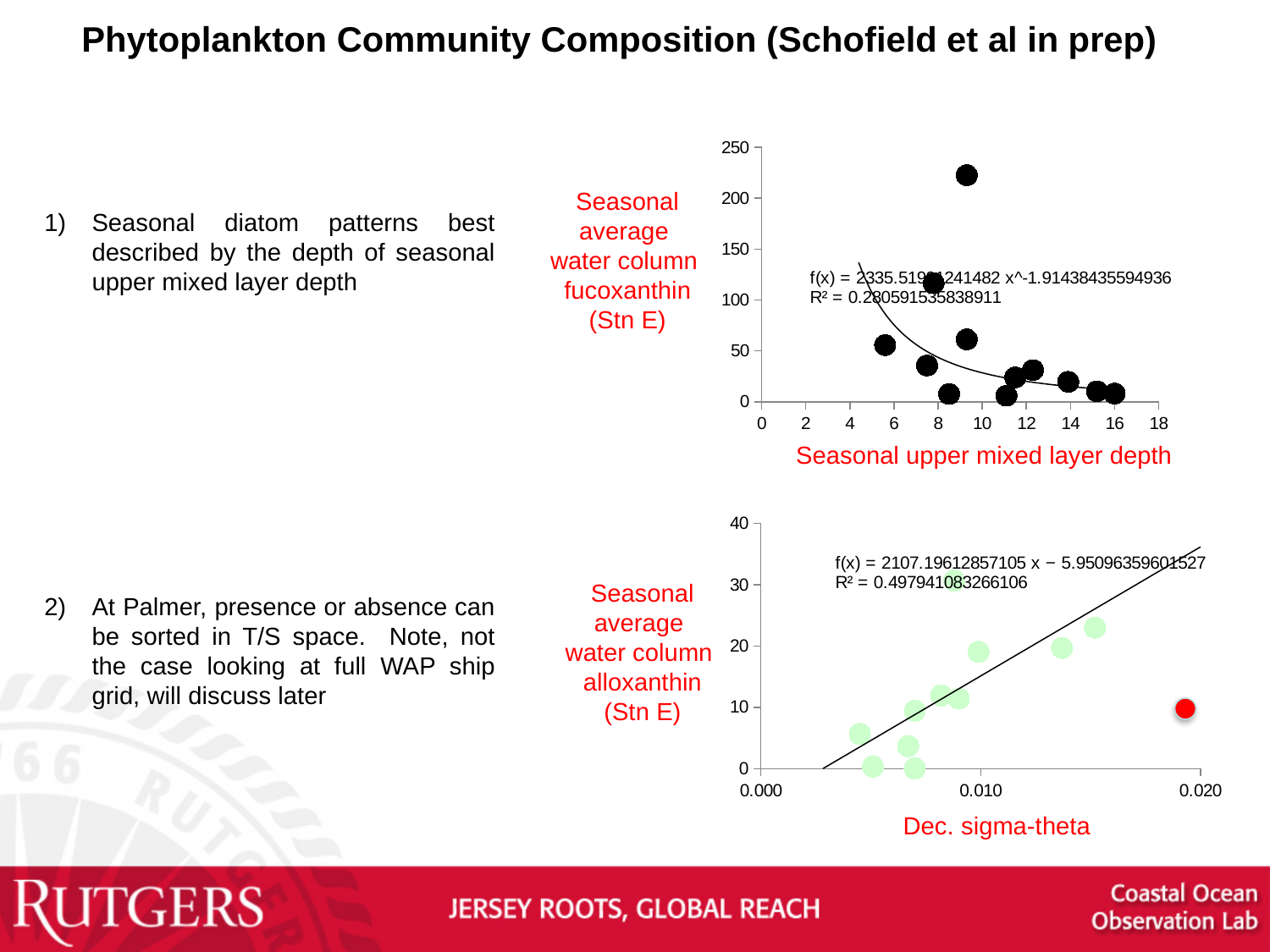
In the bottom chart, do the alloxanthin values generally rise or fall as Dec. sigma-theta increases along the x axis? rise What kind of chart is the bottom chart (Seasonal average water column alloxanthin)? scatter chart In the bottom chart, what is the label of the x axis? Dec. sigma-theta In the top chart, does the fitted curve rise or fall as seasonal upper mixed layer depth increases? fall What R² value is printed on the bottom chart? 0.497941083266106 In the bottom chart, is the Dec. sigma-theta value of the red point greater or less than 0.010? greater What is the highest tick value shown on the y axis of the top chart? 250 In the bottom chart, is the alloxanthin value of the red point greater or less than 20? less In the top chart, is the fucoxanthin value at a mixed layer depth of about 16 greater or less than 50? less What kind of chart is the top chart (Seasonal average water column fucoxanthin)? scatter chart In the top chart, what is the label of the x axis? Seasonal upper mixed layer depth